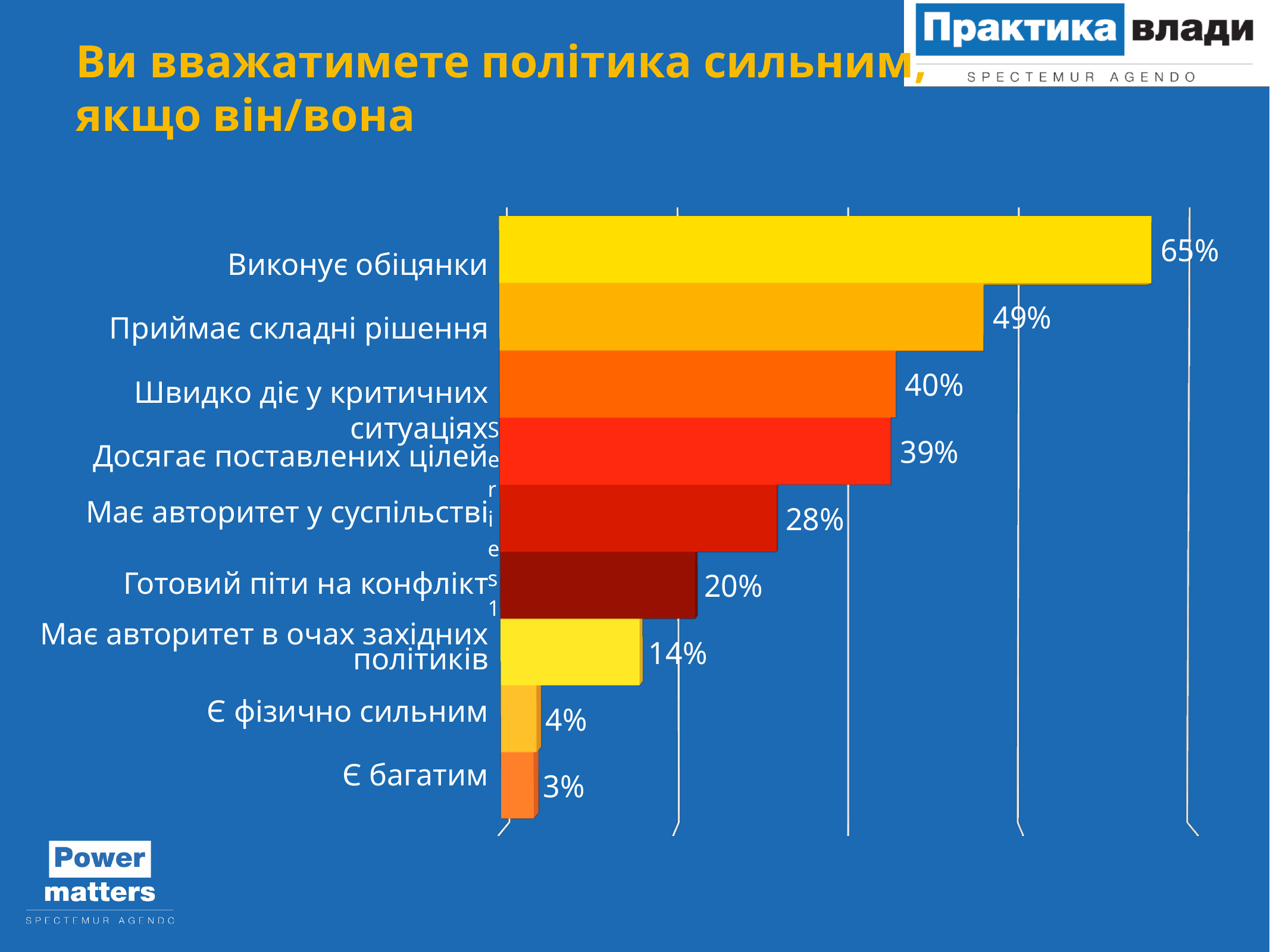
Which is larger: the value for "Швидко діє у критичних ситуаціях" or for "Має авторитет у суспільстві"? Швидко діє у критичних ситуаціях What kind of chart is shown on the slide? Bar chart How many categories are shown in the chart? 9 What is the difference between the values for "Готовий піти на конфлікт" and "Має авторитет в очах західних політиків"? 6% What is the difference between the values for "Виконує обіцянки" and "Приймає складні рішення"? 16% What is the title of the slide? Ви вважатимете політика сильним, якщо він/вона Which category has the highest value? Виконує обіцянки What value is shown for "Має авторитет у суспільстві"? 28% What value is shown for "Приймає складні рішення"? 49% Which category has the lowest value? Є багатим What value is shown for "Є фізично сильним"? 4% What value is shown for "Виконує обіцянки"? 65%